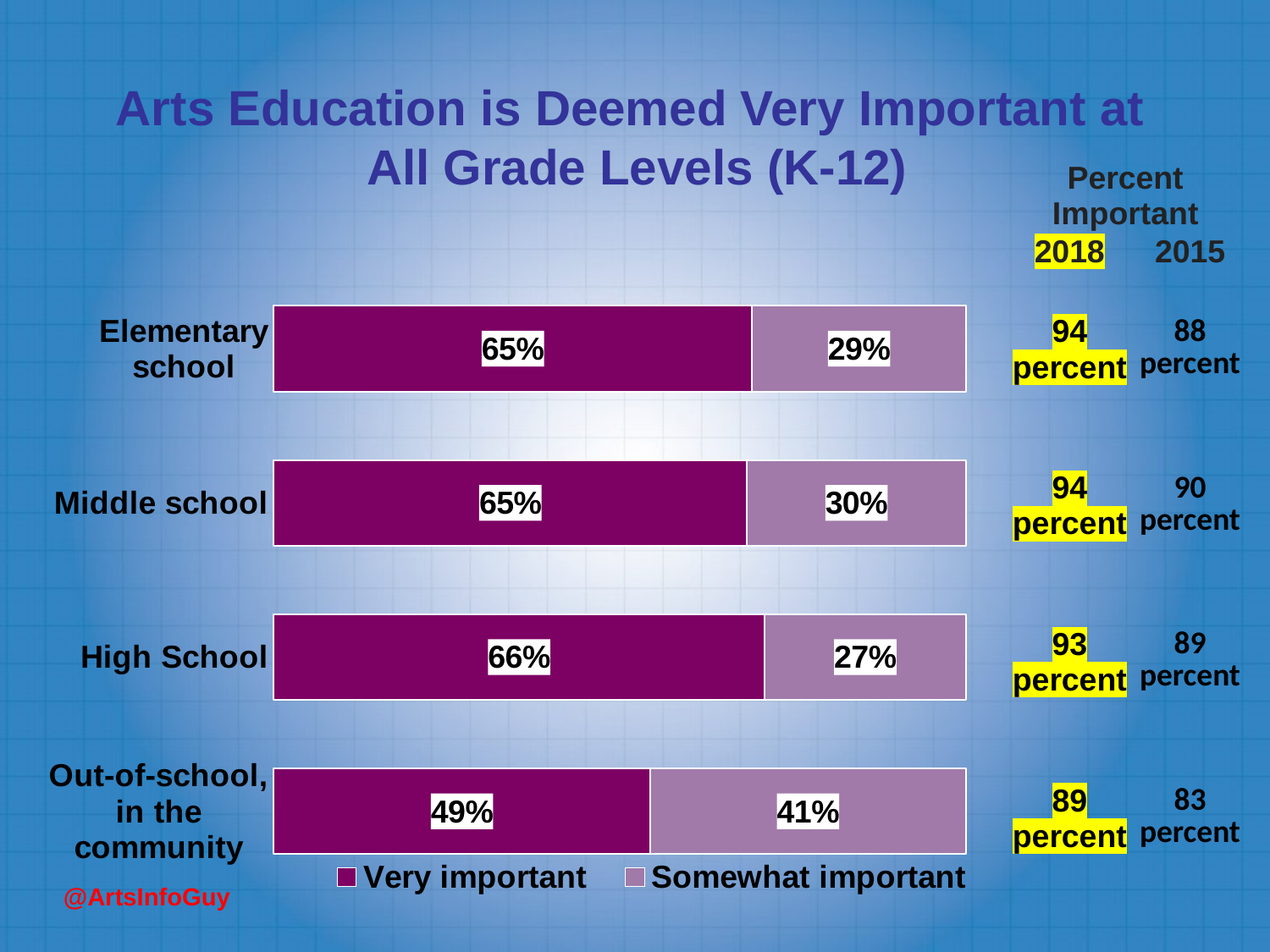
How many categories are shown in the chart? 4 Which category has the highest 'Somewhat important' value? Out-of-school, in the community What kind of chart is shown on the slide? Stacked bar chart Which category has the lowest 'Very important' value? Out-of-school, in the community What is the total of the stacked bar for Middle school? 95% Which category has the highest 'Very important' value? High School What is the 'Somewhat important' value for Out-of-school, in the community? 41% What is the difference between the 'Very important' values for High School and Out-of-school, in the community? 17% Is the 'Very important' value larger for Middle school or for Out-of-school, in the community? Middle school How many series does the legend list? 2 What is the 'Somewhat important' value for High School? 27% What percentage of respondents rated arts education in elementary school as very important? 65%